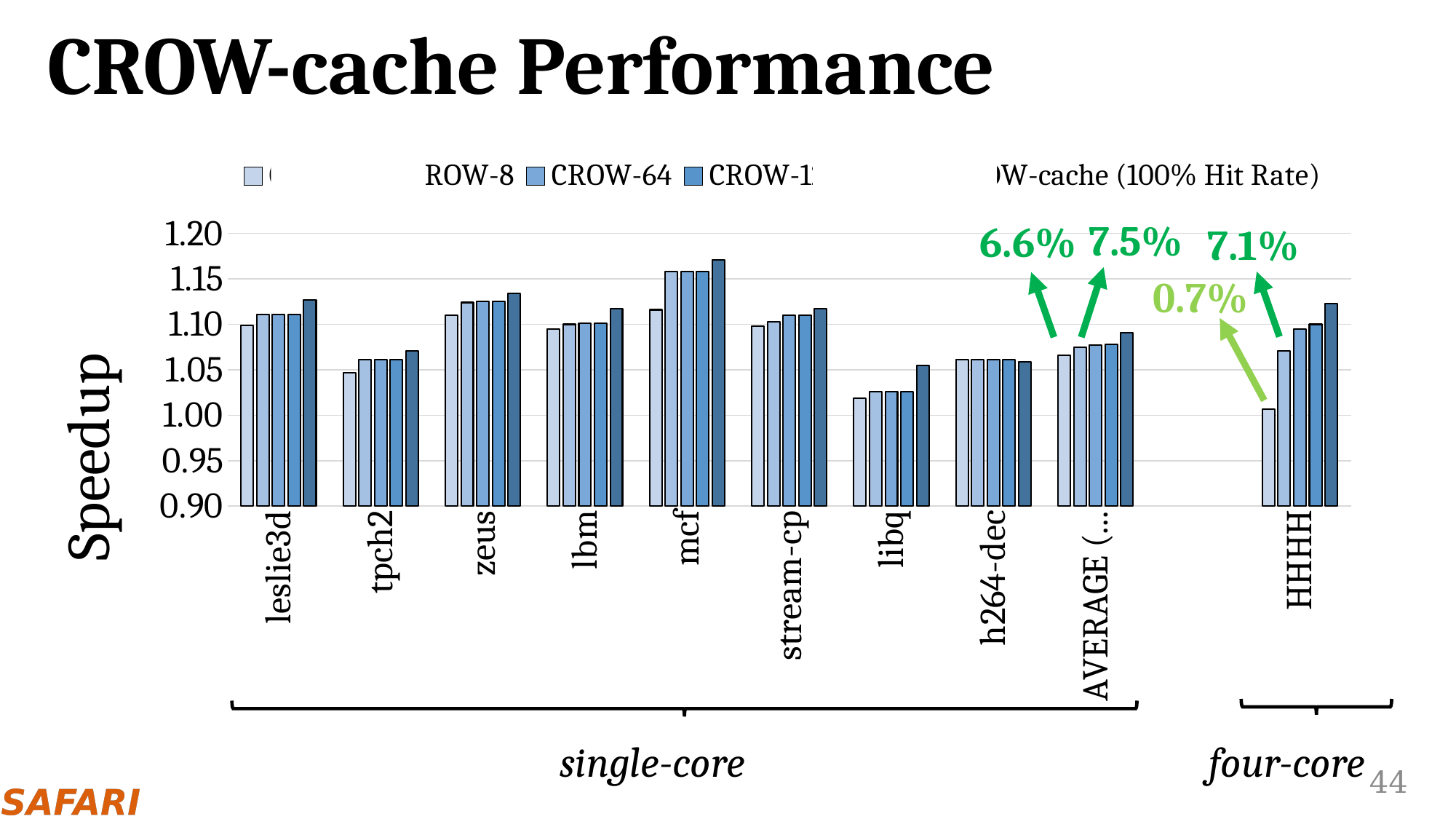
What percentage is annotated above the tallest bar of the four-core HHHH workload? 7.1% What kind of chart is shown on the slide? bar chart Which workload has higher speedup bars, zeus or tpch2? zeus Is the lightest bar for libq greater or less than 1.05? less How many bars are plotted for each workload category? 5 Which workload has the highest speedup bars? mcf Is the lightest bar for HHHH greater or less than 1.05? less What is the label on the y axis? Speedup Among the single-core workloads, which has the lowest speedup bars? libq Is the tallest bar for mcf greater or less than 1.15? greater How many workload categories are shown along the x axis? 10